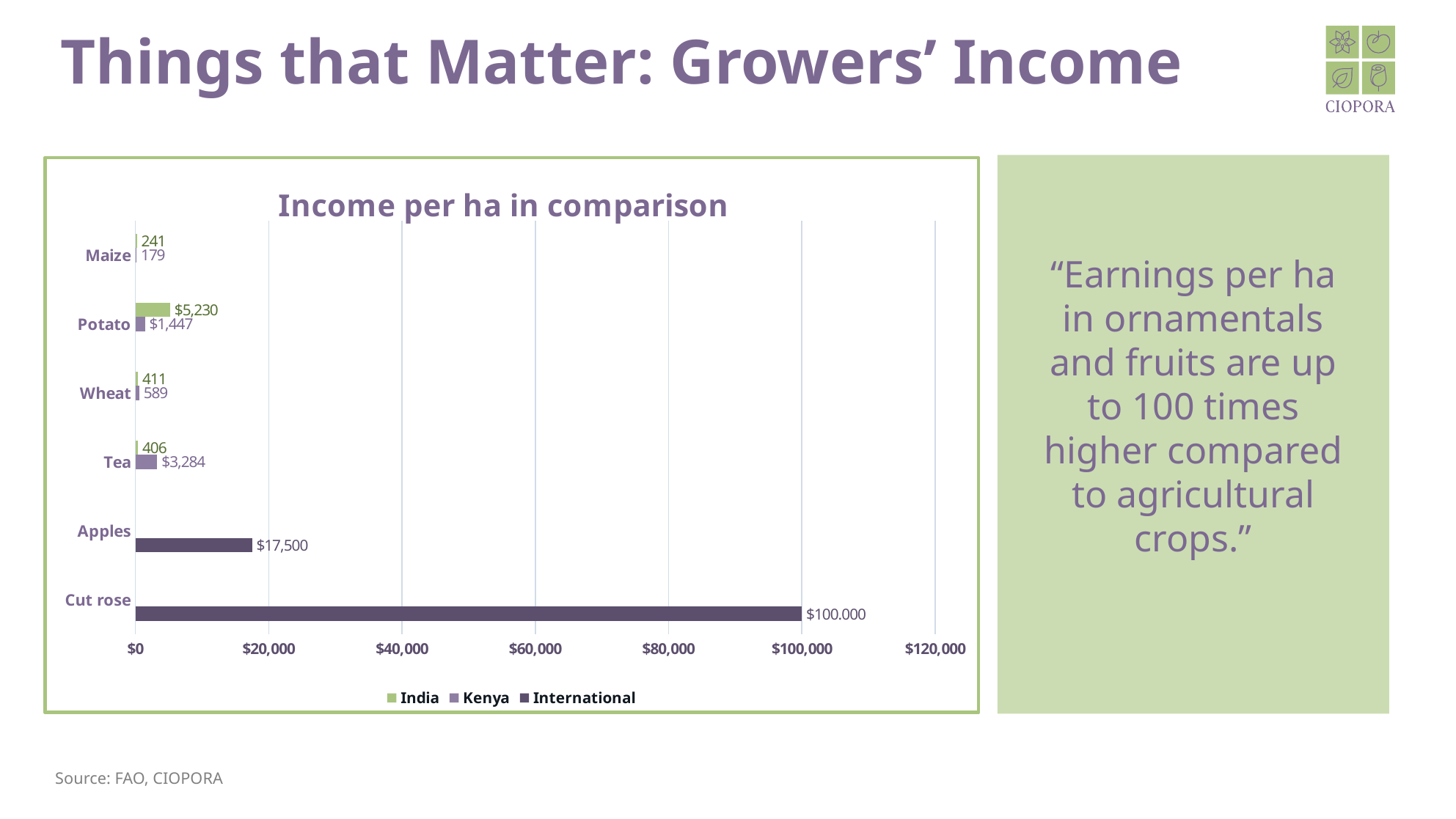
Which crop has the highest income per ha on the chart? Cut rose What is the International income per ha for Apples? $17,500 What is the Kenya value for Tea? $3,284 What is the title of the chart? Income per ha in comparison What is the difference between the India and Kenya values for Potato? $3,783 How many series does the chart legend list? 3 Which is larger for Wheat, the India value or the Kenya value? Kenya What is the difference between the International values for Cut rose and Apples? $82,500 What kind of chart is shown on the slide? Bar chart What is the International income per ha for Cut rose? $100,000 What is the India value for Potato? $5,230 How many crop categories are shown on the chart? 6